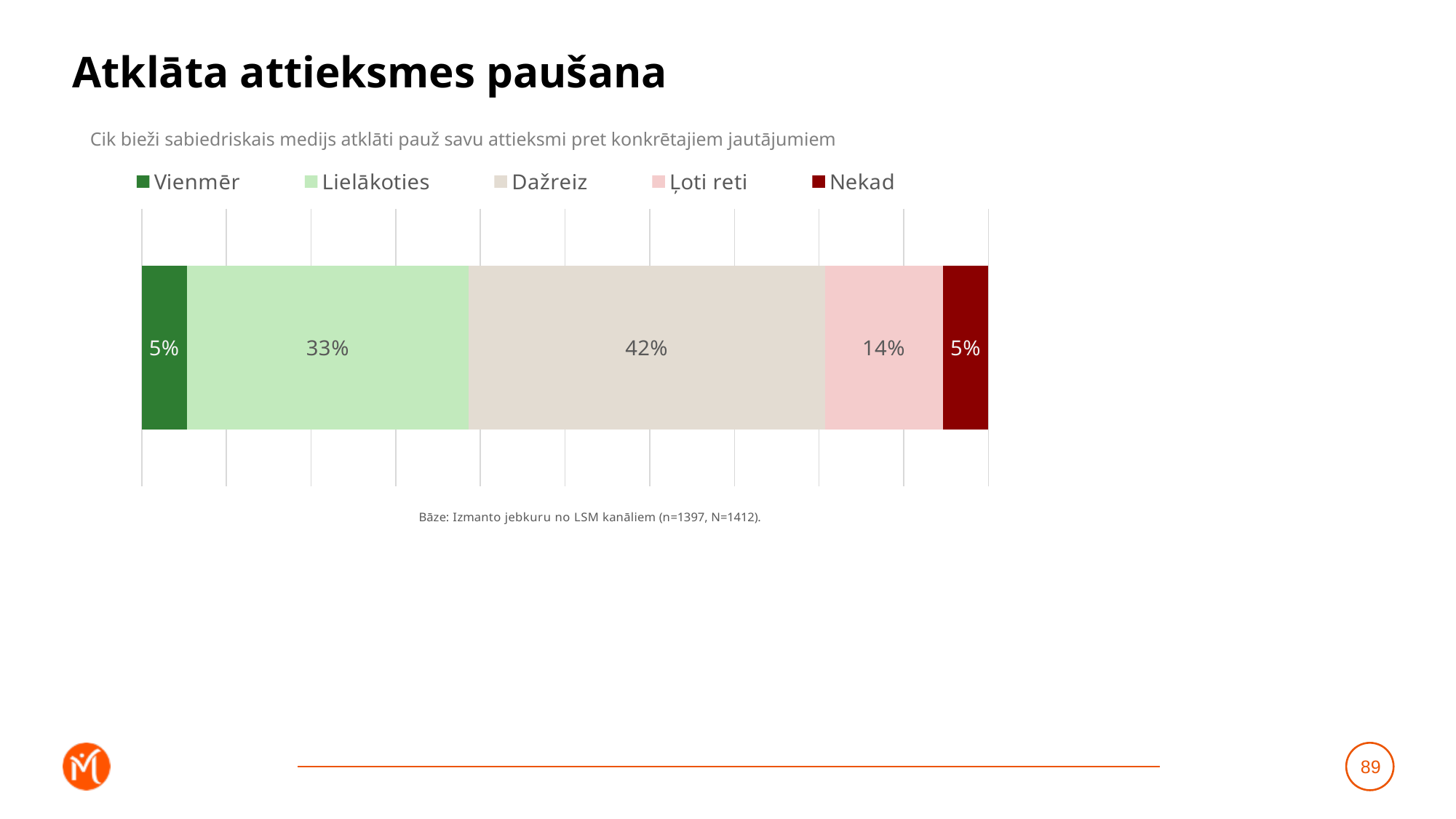
What percentage is shown for the "Ļoti reti" segment? 14% What percentage is shown for the "Nekad" segment? 5% What percentage is shown for the "Vienmēr" segment? 5% What percentage is shown for the "Lielākoties" segment? 33% What kind of chart is shown on the slide? Stacked bar chart Which segment has the largest share? Dažreiz How many series does the legend list? 5 What is the difference between the "Dažreiz" and "Lielākoties" segments? 9 percentage points What is the total of all segments in the stacked bar? 99% What percentage is shown for the "Dažreiz" segment? 42% Which is larger, the "Lielākoties" segment or the "Ļoti reti" segment? Lielākoties Which legend entry is shown in dark red? Nekad